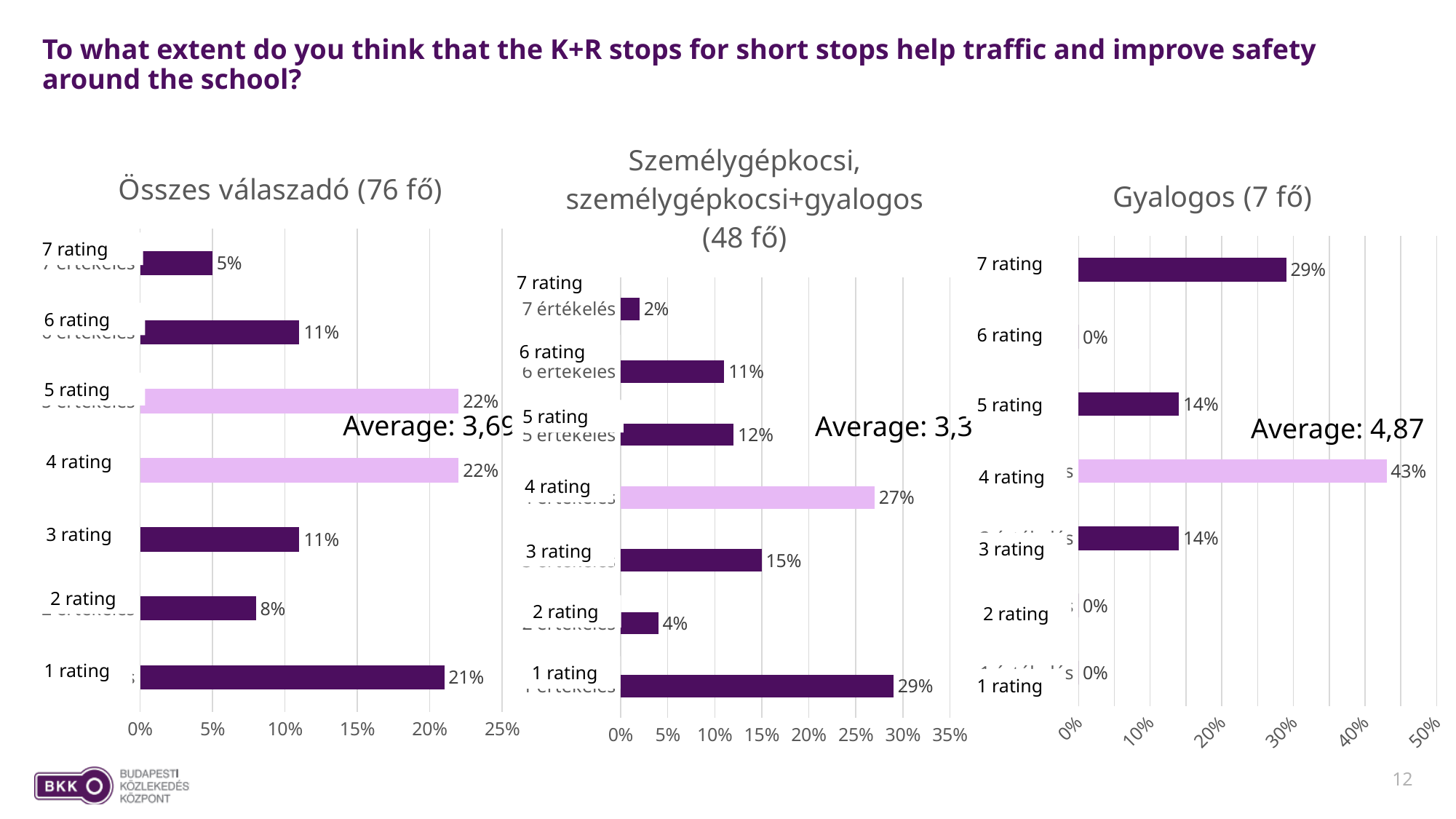
In the 'Személygépkocsi, személygépkocsi+gyalogos (48 fő)' chart, which rating has the highest percentage? 1 rating In the 'Összes válaszadó (76 fő)' chart, what is the difference between the 1 rating and the 2 rating percentages? 13% In the 'Gyalogos (7 fő)' chart, which rating has the highest percentage? 4 rating What average is shown on the 'Gyalogos (7 fő)' chart? 4,87 In the 'Gyalogos (7 fő)' chart, how many rating categories are shown? 7 In the 'Személygépkocsi, személygépkocsi+gyalogos (48 fő)' chart, which is larger: the 3 rating or the 5 rating percentage? 3 rating In the 'Személygépkocsi, személygépkocsi+gyalogos (48 fő)' chart, what percentage gave a 4 rating? 27% In the 'Összes válaszadó (76 fő)' chart, which rating has the lowest percentage? 7 rating What type of chart is the 'Összes válaszadó (76 fő)' chart? Bar chart In the 'Összes válaszadó (76 fő)' chart, what percentage of respondents gave a 1 rating? 21% In the 'Összes válaszadó (76 fő)' chart, what percentage gave a 7 rating? 5% In the 'Gyalogos (7 fő)' chart, what percentage gave a 4 rating? 43%